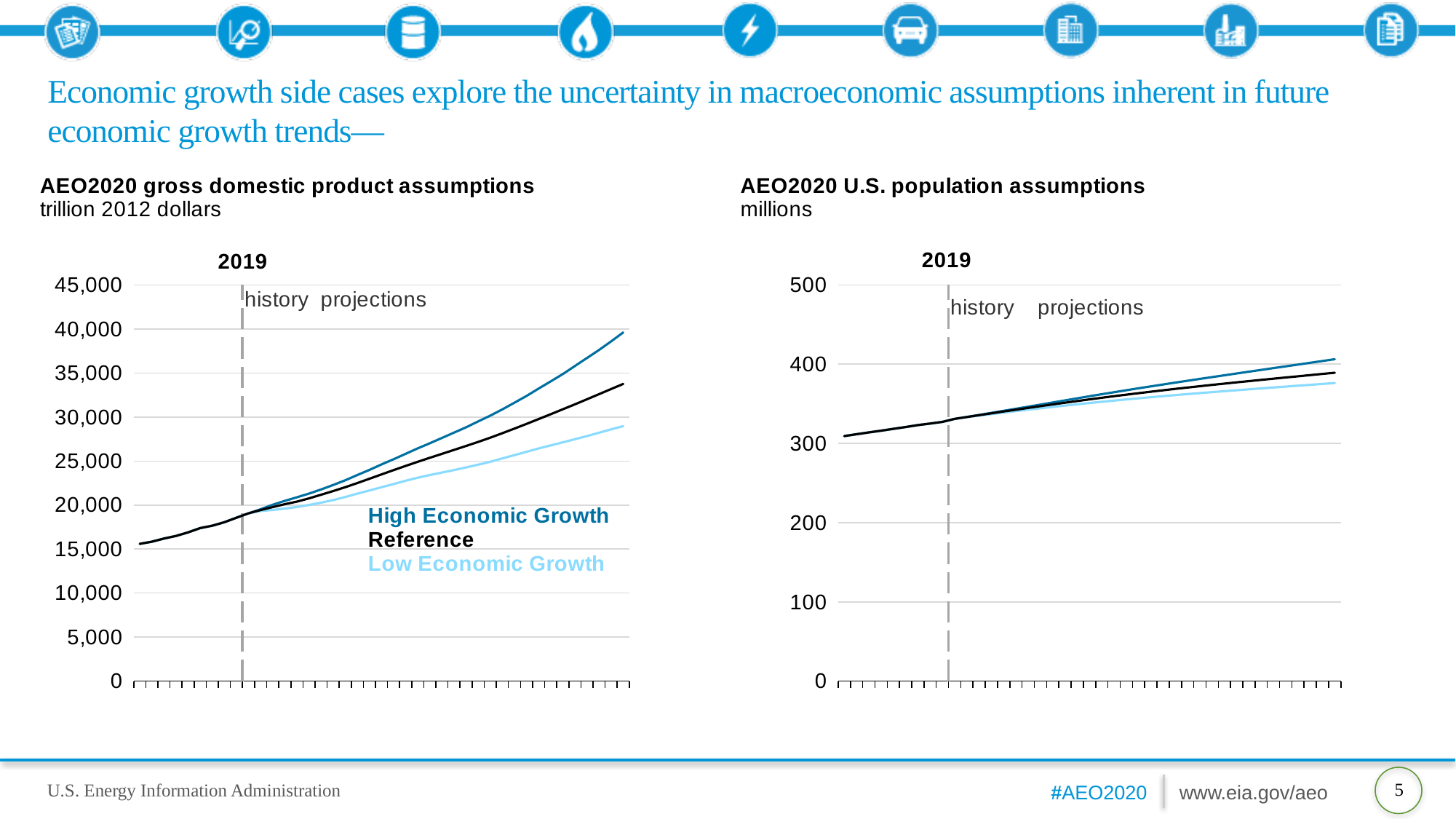
What year does the dashed vertical line separating history from projections mark on the AEO2020 gross domestic product assumptions chart? 2019 On the AEO2020 U.S. population assumptions chart, is the final value of the black Reference series greater or less than 400? less On the AEO2020 gross domestic product assumptions chart, is the final value of the Reference series greater or less than 30,000? greater How many series does the legend on the AEO2020 gross domestic product assumptions chart list? 3 On the AEO2020 gross domestic product assumptions chart, does the Reference series rise or fall over time? rise What kind of chart is the AEO2020 gross domestic product assumptions chart? line chart On the AEO2020 gross domestic product assumptions chart, is the final value of the High Economic Growth series greater or less than 35,000? greater On the AEO2020 U.S. population assumptions chart, do the values rise or fall along the x axis? rise What unit is shown under the title of the AEO2020 U.S. population assumptions chart? millions On the AEO2020 gross domestic product assumptions chart, which series ends higher at the end of the projection period, High Economic Growth or Low Economic Growth? High Economic Growth